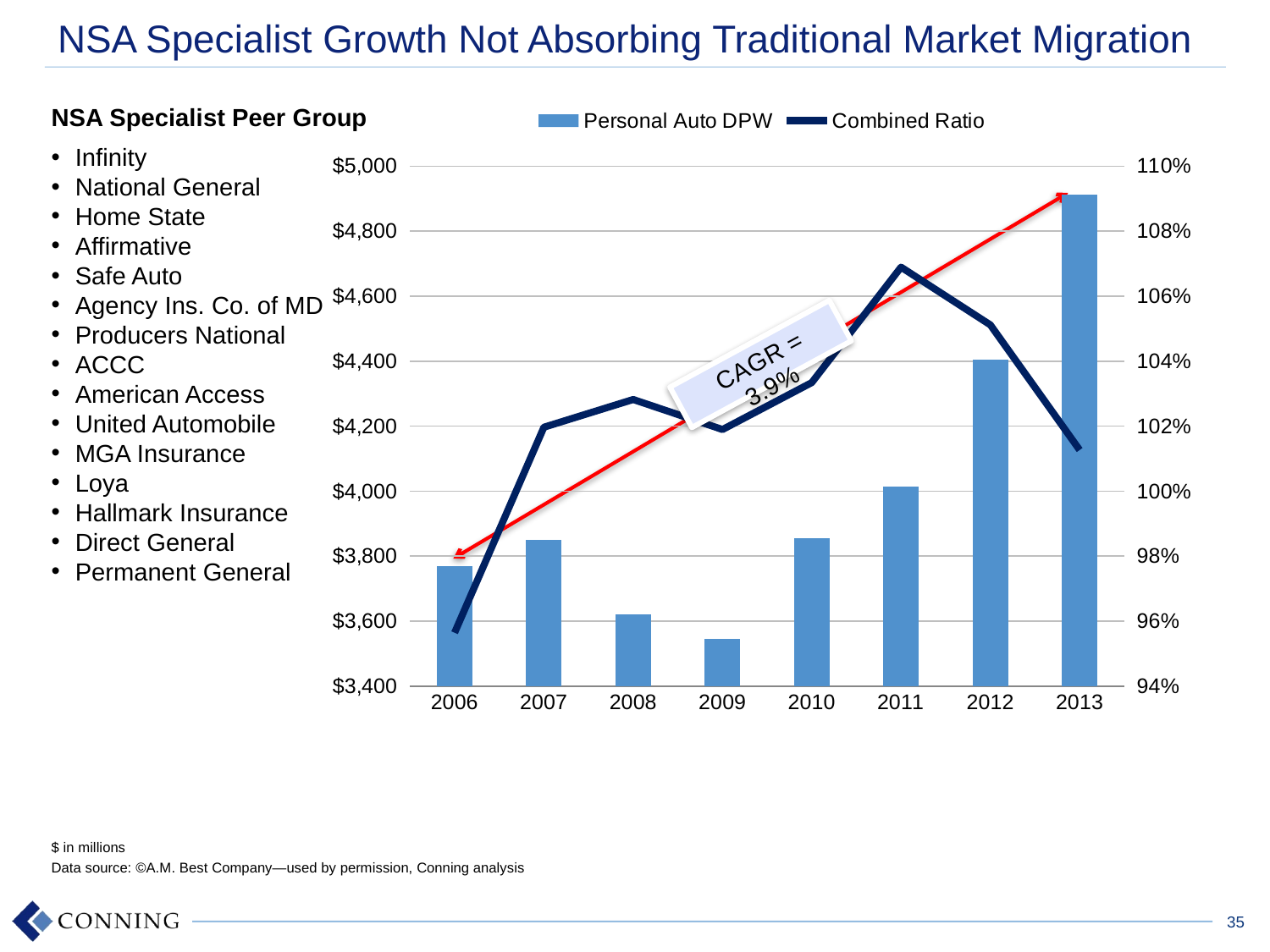
Is the Personal Auto DPW value for 2009 greater or less than $3,600? less Which year has the highest Personal Auto DPW bar? 2013 Which year has the highest Combined Ratio? 2011 Is the Personal Auto DPW value for 2013 greater or less than $4,800? greater Is the Combined Ratio for 2006 greater or less than 98%? less Which year has the lowest Personal Auto DPW bar? 2009 How many years are shown on the x axis of the chart? 8 How many series does the chart legend list? 2 Which year has the lowest Combined Ratio? 2006 Is the Personal Auto DPW bar for 2012 or 2011 taller? 2012